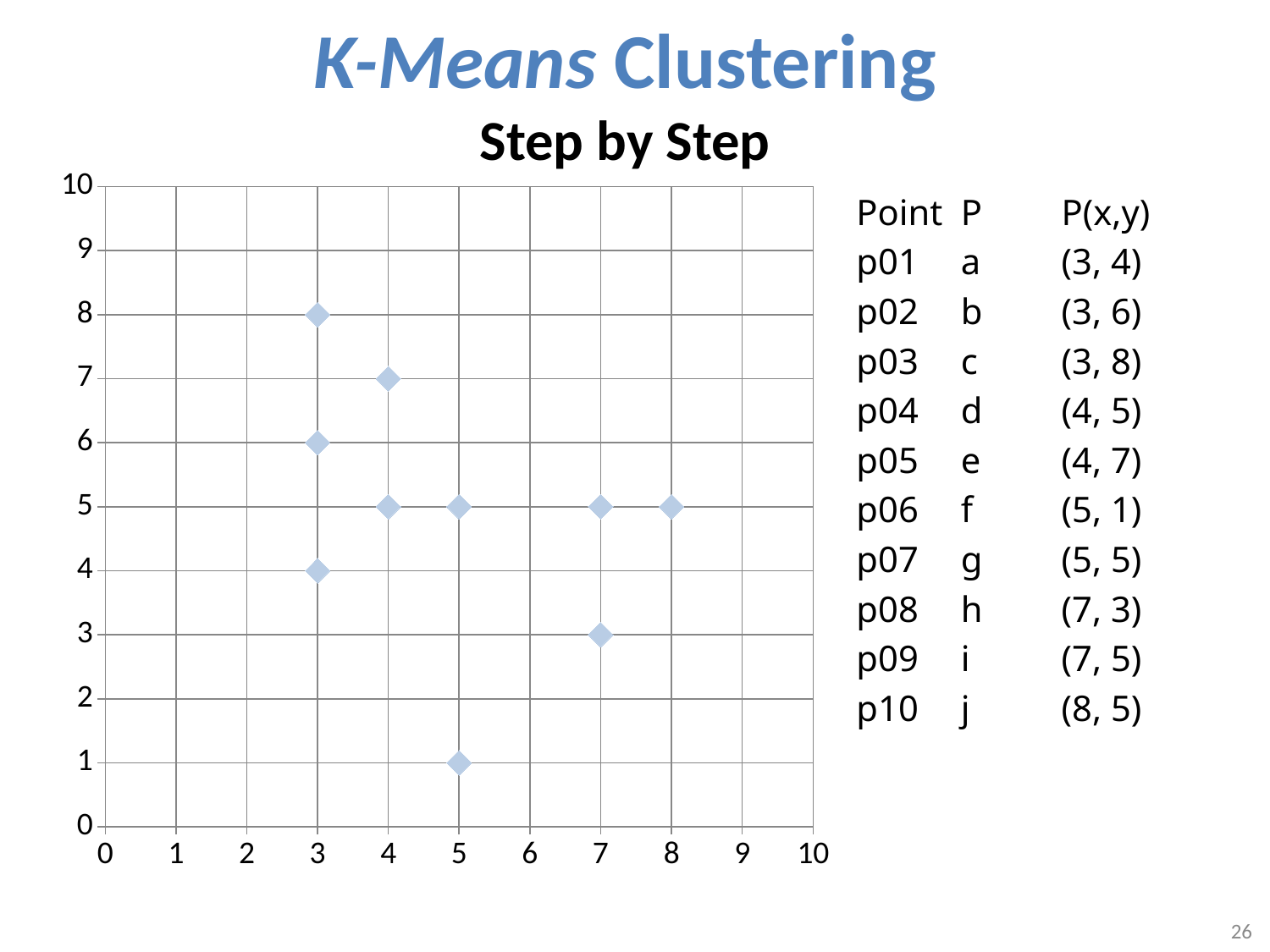
What is the largest x-value among the plotted points? 8 Is the y-value of the point at x = 5 with the lowest y greater or less than 2? less What is the x-value of the point plotted at y = 1? 5 How many points are plotted at y = 5? 4 What is the difference in y-value between the highest point and the lowest point on the chart? 7 What kind of chart is shown on the slide? scatter chart What is the highest y-value among the plotted points? 8 How many data points are plotted on the chart? 10 What is the lowest y-value among the plotted points? 1 How many points are plotted at x = 3? 3 What is the maximum value shown on the y-axis? 10 What is the y-value of the point plotted at x = 8? 5